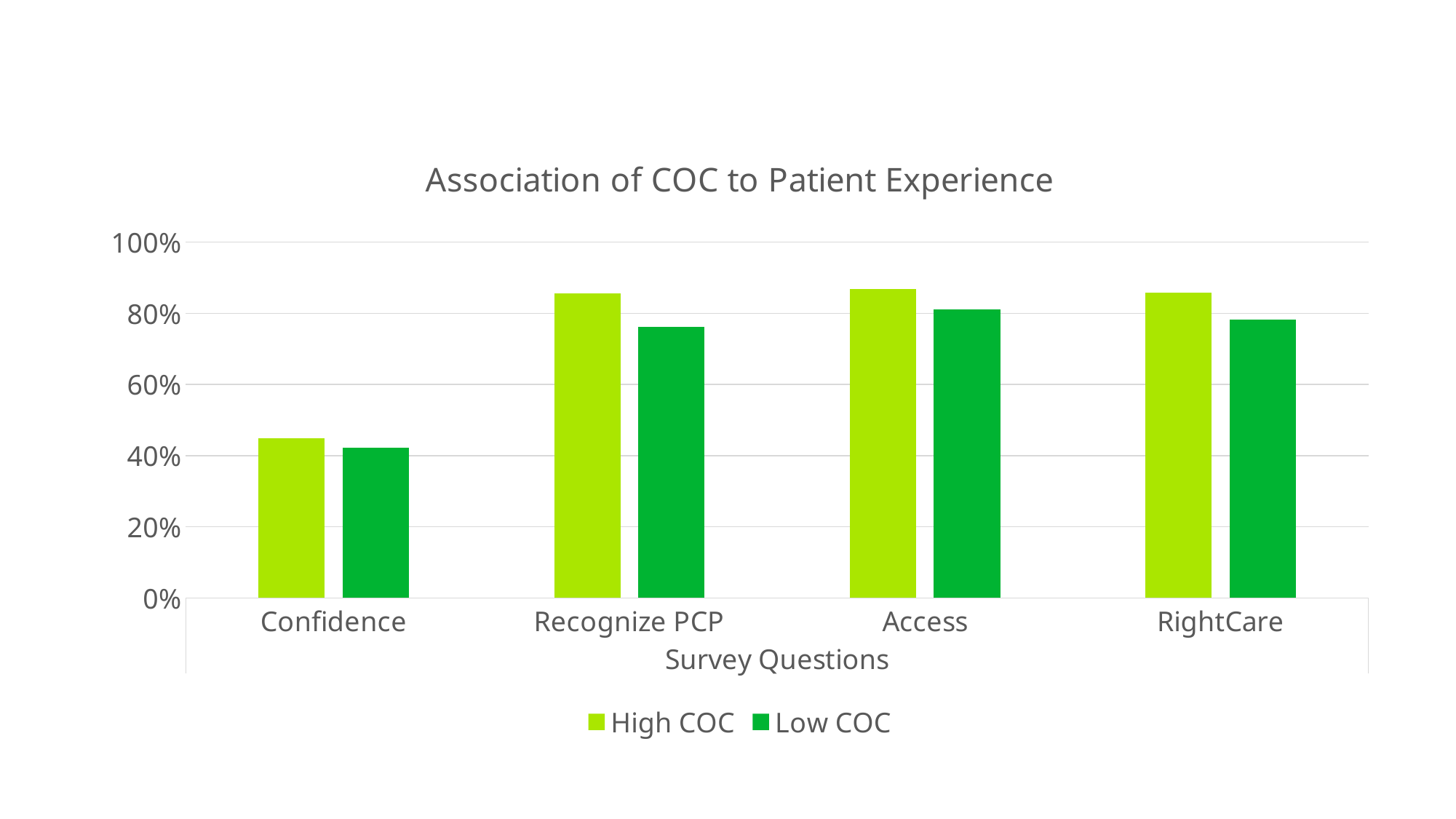
What type of chart is shown on the slide? bar chart How many survey question categories are shown on the x axis? 4 Is the High COC value for Access greater or less than 80%? greater What is the title of the chart? Association of COC to Patient Experience How many series does the legend list? 2 Which survey question has the lowest Low COC value? Confidence What is the x-axis title of the chart? Survey Questions Which survey question has the lowest High COC value? Confidence Is the Low COC value for Recognize PCP greater or less than 80%? less For Access, which is larger: High COC or Low COC? High COC Is the High COC value for Confidence greater or less than 60%? less For Recognize PCP, which is larger: High COC or Low COC? High COC